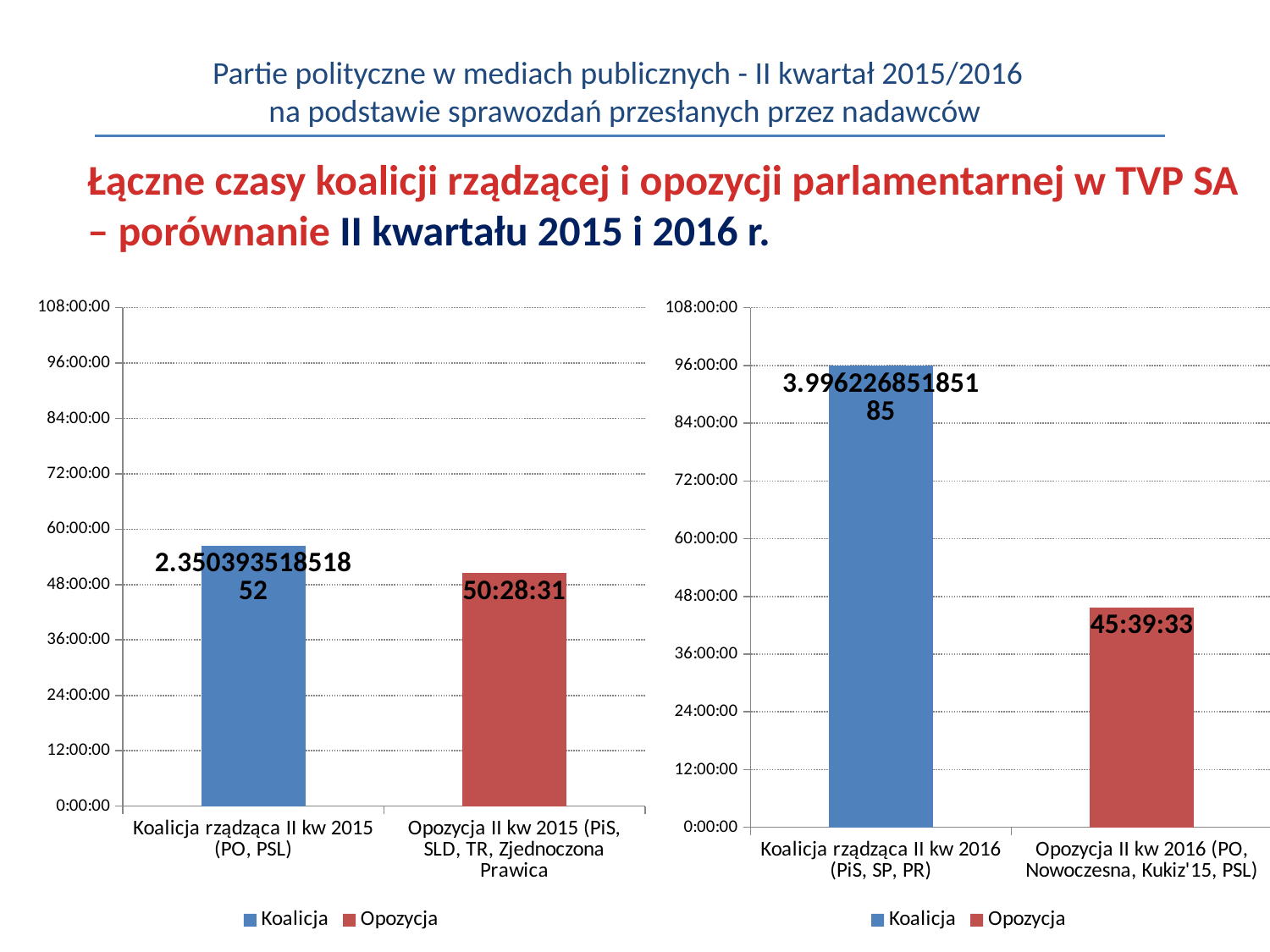
In the left chart (II kw 2015), what is the value shown for Opozycja II kw 2015 (PiS, SLD, TR, Zjednoczona Prawica)? 50:28:31 In the left chart (II kw 2015), is the value for Koalicja rządząca II kw 2015 (PO, PSL) greater or less than 48:00:00? greater What kind of chart is the left chart (II kw 2015)? bar chart In the left chart (II kw 2015), which category has the lowest bar? Opozycja II kw 2015 (PiS, SLD, TR, Zjednoczona Prawica) Which is larger: the Opozycja value in the left chart (II kw 2015) or the Opozycja value in the right chart (II kw 2016)? Opozycja II kw 2015 (50:28:31) How many categories are plotted in the left chart (II kw 2015)? 2 How many series does the legend of the right chart (II kw 2016) list? 2 In the right chart (II kw 2016), which category has the highest bar? Koalicja rządząca II kw 2016 (PiS, SP, PR) What is the difference between the Opozycja value in the left chart (50:28:31) and the Opozycja value in the right chart (45:39:33)? 4:48:58 In the legend of the left chart, what colour represents Koalicja? blue In the right chart (II kw 2016), is the value for Koalicja rządząca II kw 2016 (PiS, SP, PR) greater or less than 84:00:00? greater In the right chart (II kw 2016), what is the value shown for Opozycja II kw 2016 (PO, Nowoczesna, Kukiz'15, PSL)? 45:39:33